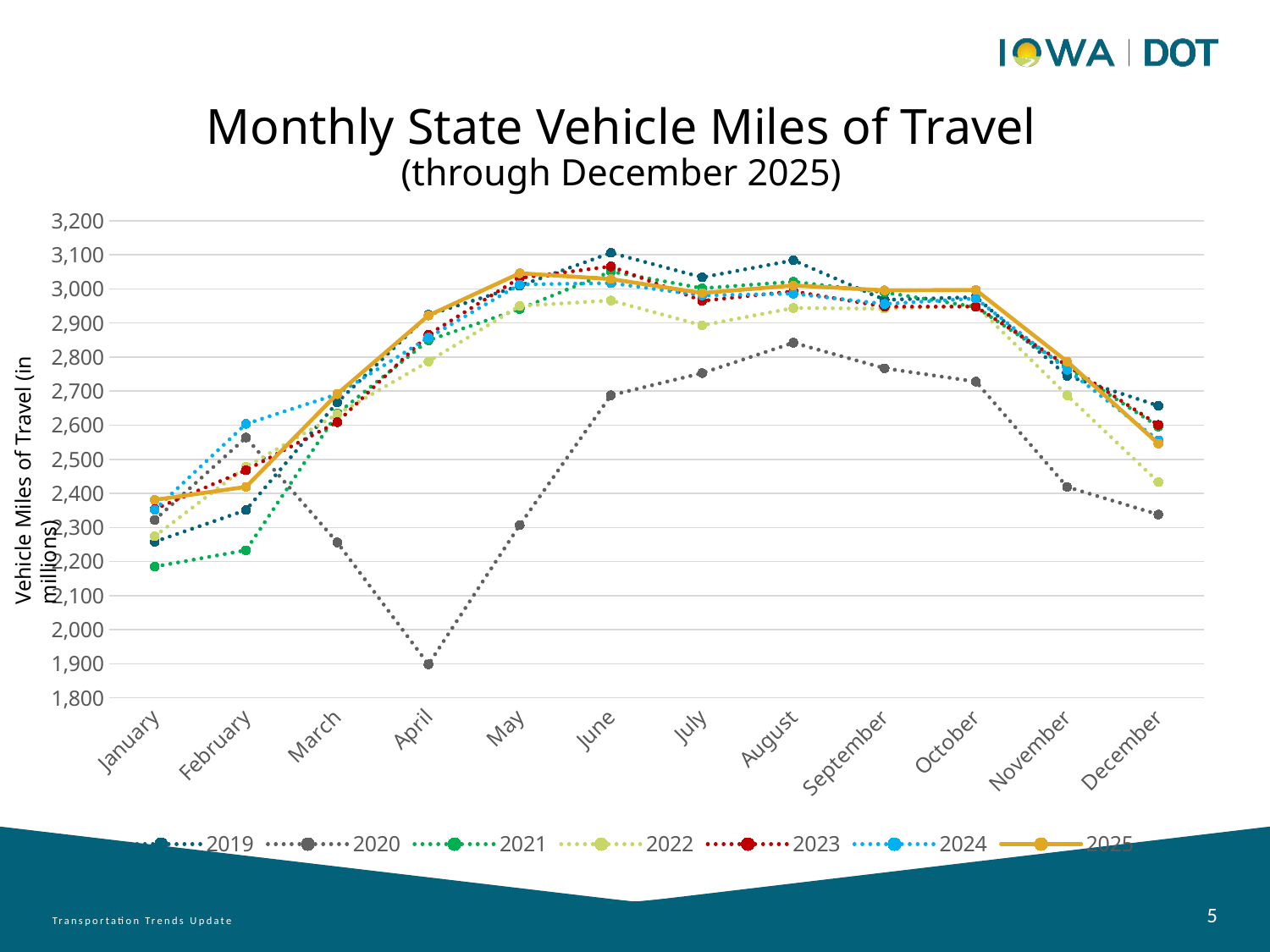
Which year has the lowest value in April? 2020 Which year has the lowest value in December? 2020 Is the value for 2020 in December greater or less than 2,400? less Which is larger for 2020: the value in February or the value in March? February Is the value for 2020 in April greater or less than 2,000? less Do the values for 2025 rise or fall from January to May? rise What is the title of the chart? Monthly State Vehicle Miles of Travel (through December 2025) How many series does the legend list? 7 How many months are shown along the x axis? 12 Is the value for 2025 in May greater or less than 3,000? greater What kind of chart is shown on the slide? line chart Which year has the highest value in June? 2019